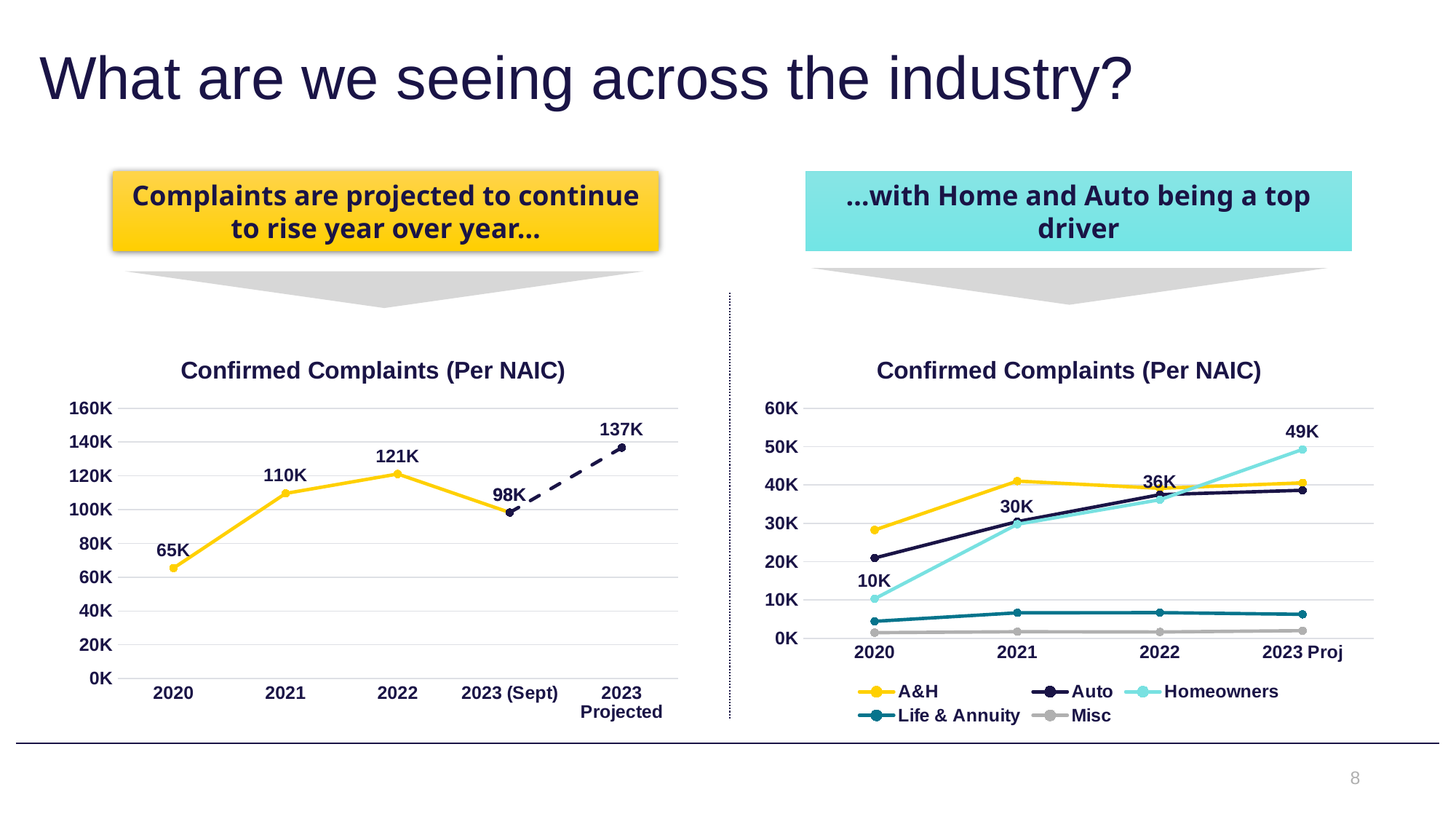
In the left chart, what is the difference between the 2022 value and the 2021 value? 11K In the left chart, which category has the lowest value? 2020 How many series does the legend of the right chart list? 5 In the left chart, which is larger: the value for 2022 or the value for 2023 (Sept)? 2022 What kind of chart is the left chart on the slide? line chart In the left chart, what is the value of confirmed complaints for 2020? 65K How many categories are plotted on the x axis of the left chart? 5 In the right chart, what is the Homeowners value for 2023 Proj? 49K In the right chart, is the Life & Annuity value for 2022 greater or less than 10K? less In the right chart, what is the Homeowners value for 2020? 10K In the left chart, which category has the highest value? 2023 Projected In the left chart, what is the value for 2023 Projected? 137K